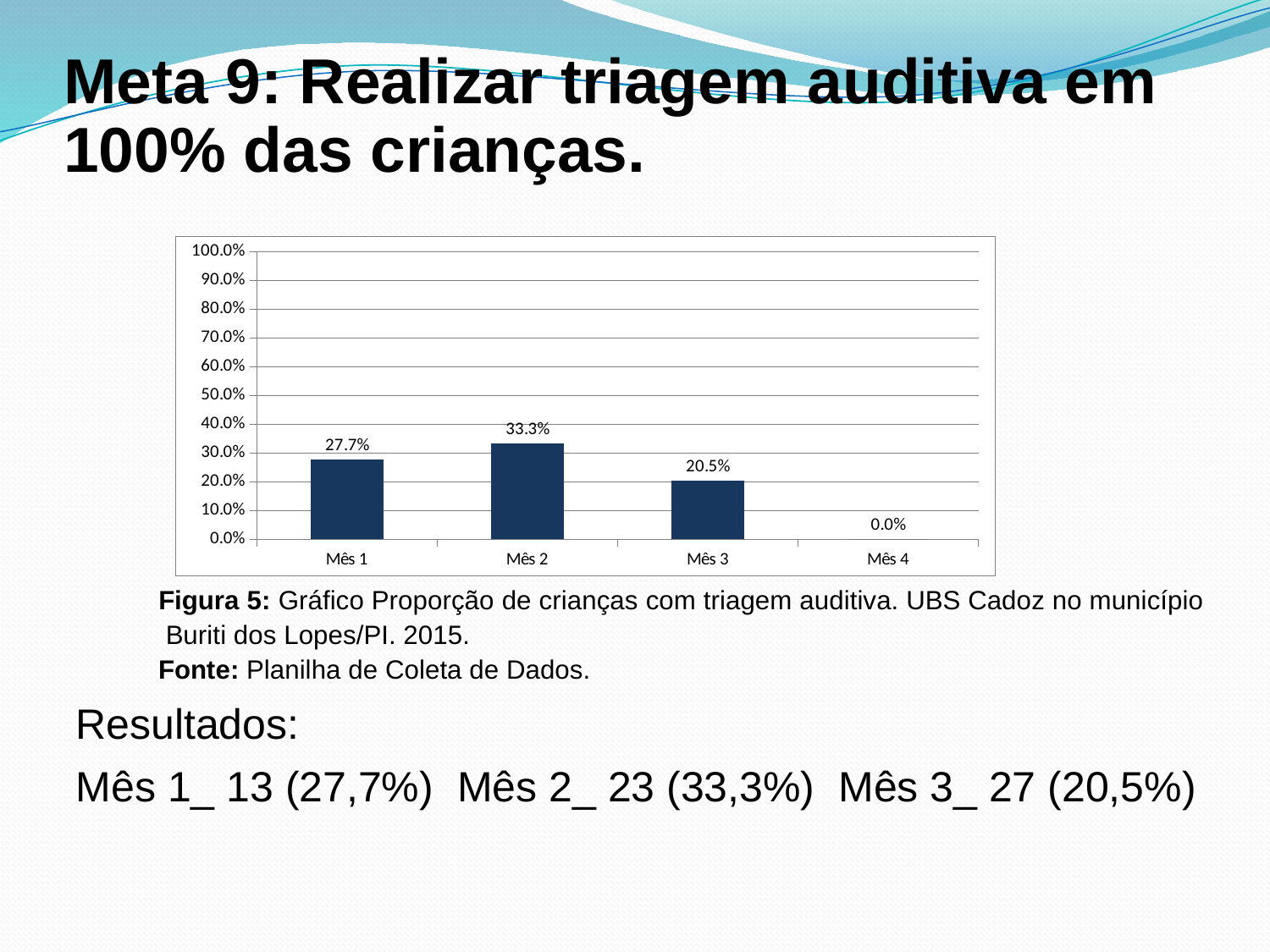
What is the value for Mês 4? 0.0% What is the difference between the values for Mês 2 and Mês 3? 12.8% How many months are shown on the x axis? 4 What is the highest value shown on the y axis? 100.0% Which month has the lowest value? Mês 4 Which is larger, the value for Mês 1 or the value for Mês 3? Mês 1 What is the value for Mês 3? 20.5% Is the value for Mês 2 greater or less than 30.0%? greater Which month has the highest value? Mês 2 What is the value for Mês 1? 27.7% What is the value for Mês 2? 33.3% What kind of chart is shown on the slide? bar chart